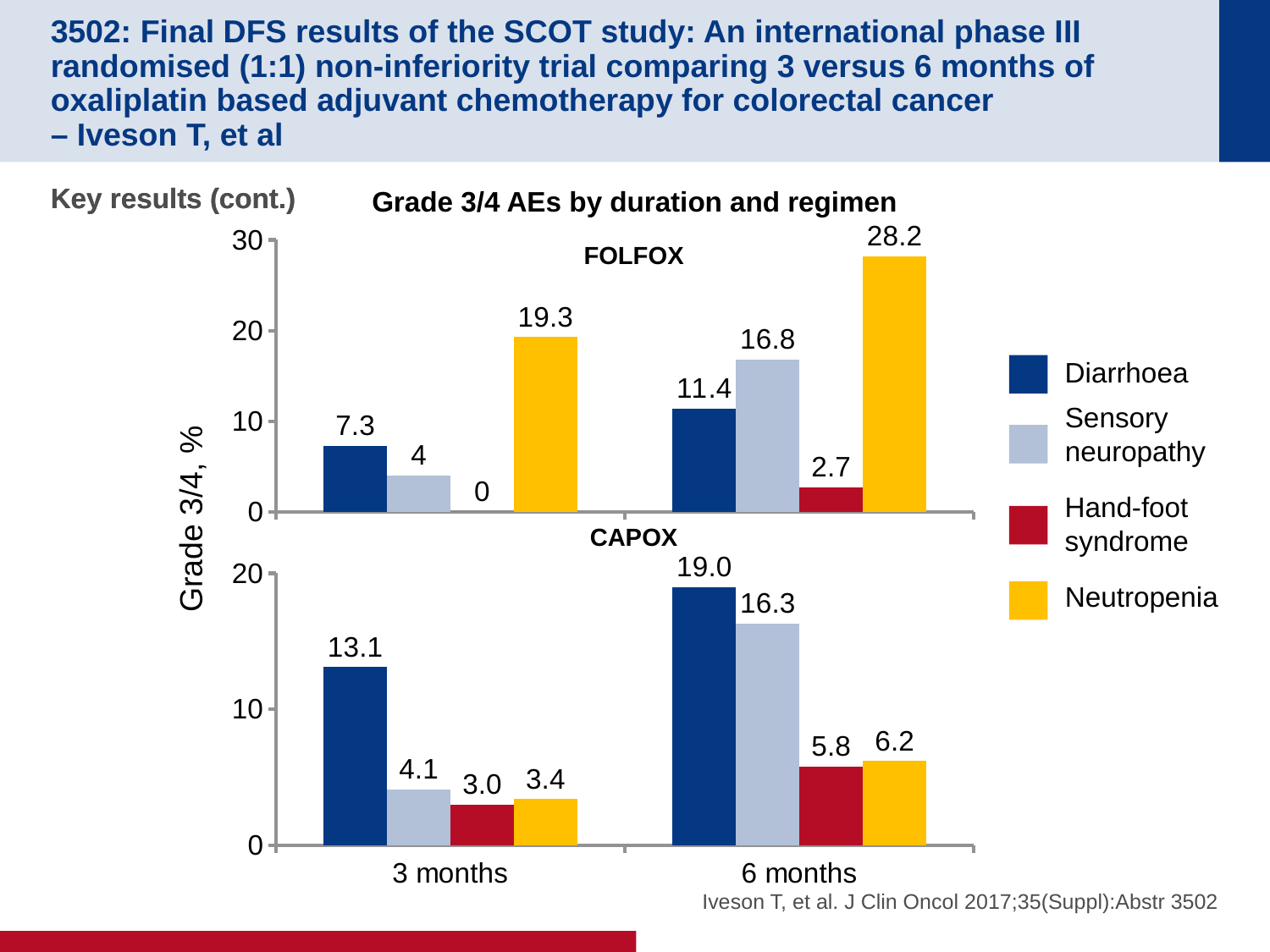
In the CAPOX chart, what is the Grade 3/4 diarrhoea rate at 3 months? 13.1 What type of chart is used to show Grade 3/4 AEs by duration and regimen? Bar chart In the FOLFOX chart, what is the difference in Grade 3/4 neutropenia rate between 6 months and 3 months? 8.9 In the FOLFOX chart, what is the Grade 3/4 neutropenia rate at 6 months? 28.2 In the CAPOX chart, what is the difference in Grade 3/4 diarrhoea rate between 6 months and 3 months? 5.9 How many series does the legend list? 4 In the CAPOX chart, what is the Grade 3/4 sensory neuropathy rate at 6 months? 16.3 In the FOLFOX chart, is the Grade 3/4 sensory neuropathy rate higher at 3 months or at 6 months? 6 months In the CAPOX chart, which adverse event has the lowest Grade 3/4 rate at 3 months? Hand-foot syndrome Which colour represents neutropenia in the legend? Yellow In the FOLFOX chart, which adverse event has the highest Grade 3/4 rate at 6 months? Neutropenia In the FOLFOX chart, what is the Grade 3/4 hand-foot syndrome rate at 3 months? 0